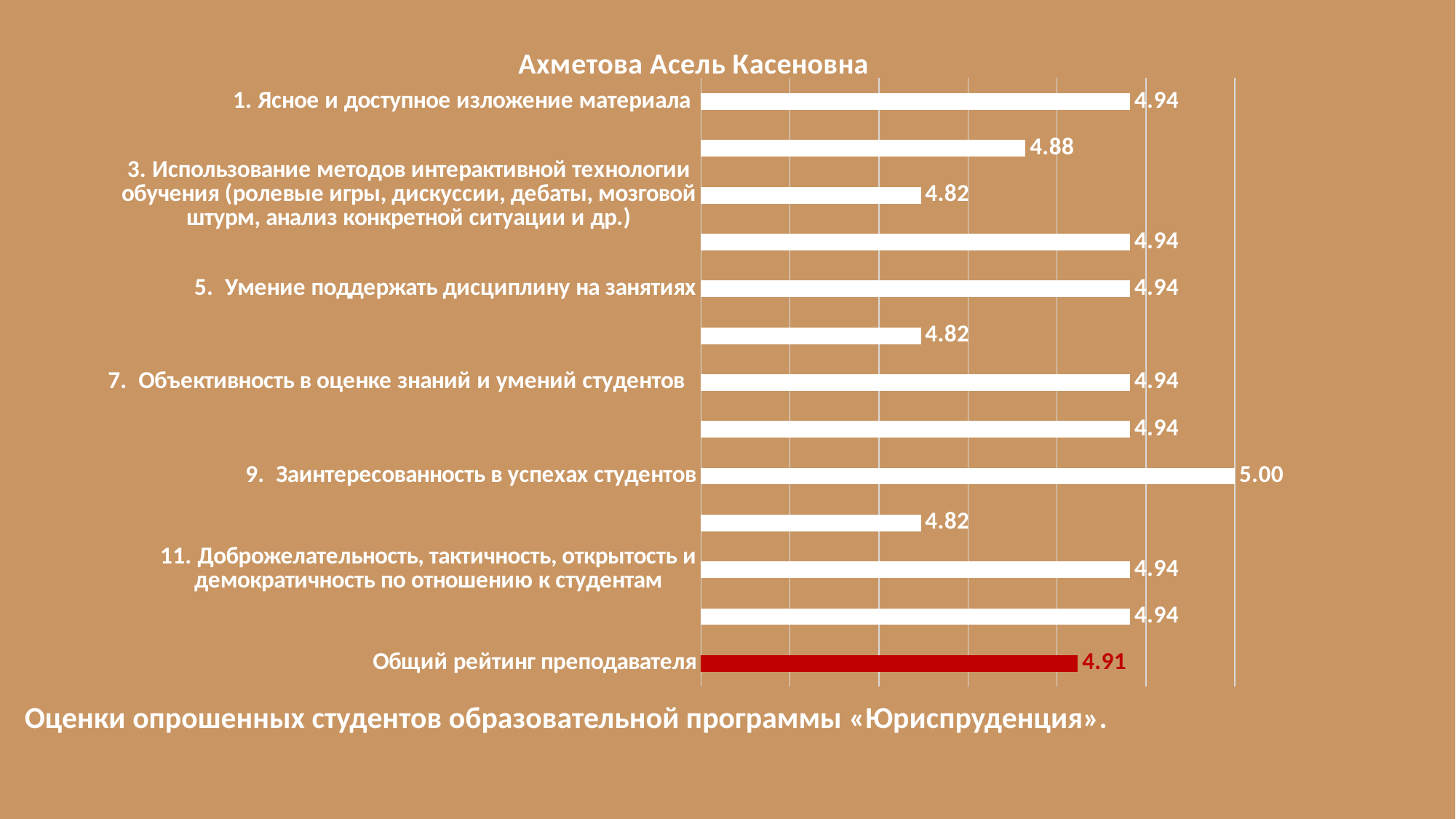
What is the value for "3. Использование методов интерактивной технологии обучения"? 4.82 What is the title of the chart? Ахметова Асель Касеновна What kind of chart is shown on the slide? Bar chart What is the value for "Общий рейтинг преподавателя"? 4.91 What is the lowest value shown on the chart? 4.82 What is the value for "1. Ясное и доступное изложение материала"? 4.94 How many bars are plotted on the chart? 13 What is the difference between the value for "9. Заинтересованность в успехах студентов" and the value for "3. Использование методов интерактивной технологии обучения"? 0.18 What is the value for "9. Заинтересованность в успехах студентов"? 5.00 Which is larger: the value for "1. Ясное и доступное изложение материала" or the value for "3. Использование методов интерактивной технологии обучения"? 1. Ясное и доступное изложение материала Which category has the highest value? 9. Заинтересованность в успехах студентов What is the value for "5. Умение поддержать дисциплину на занятиях"? 4.94